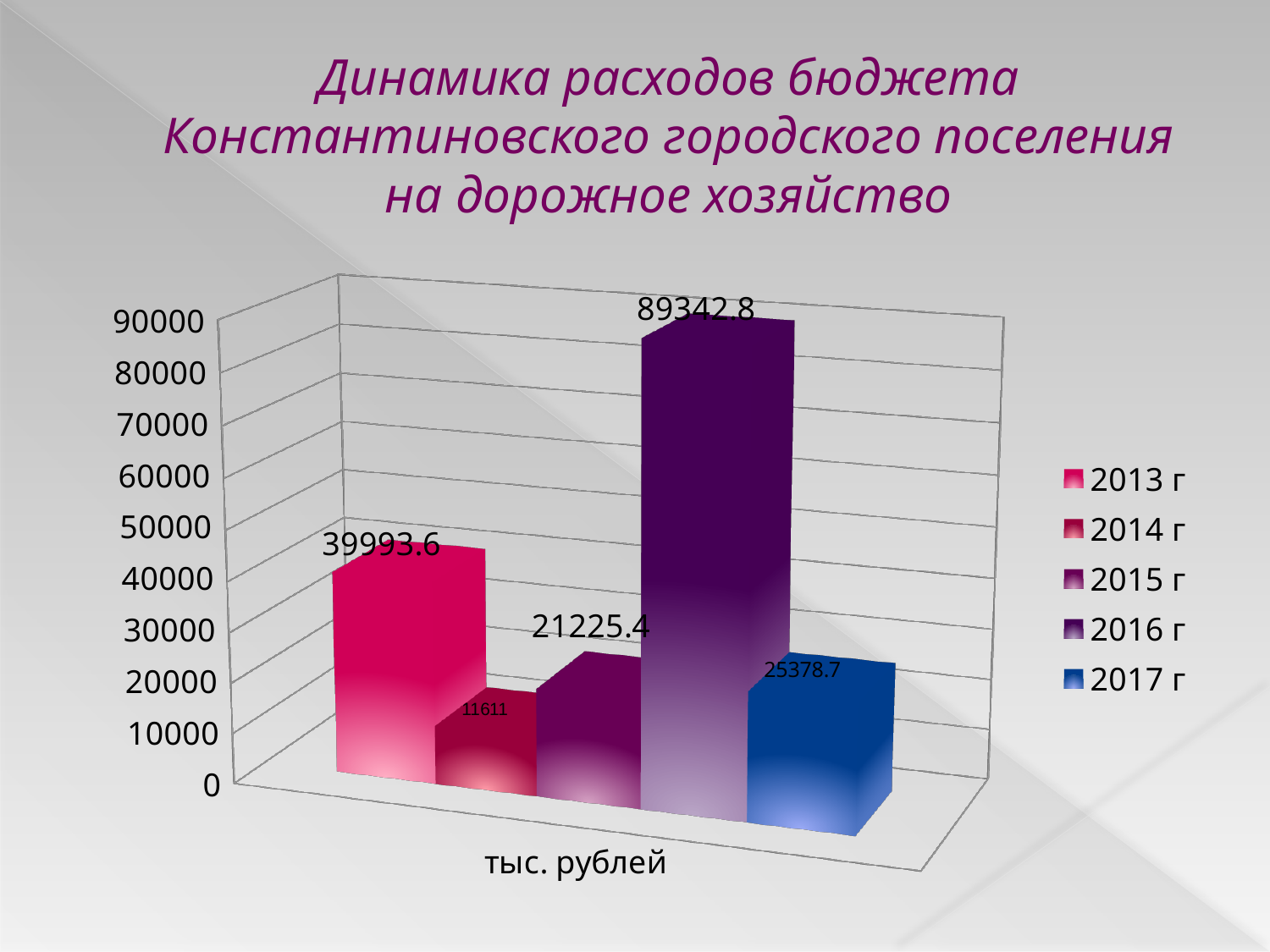
What kind of chart is shown on the slide? bar chart What is the value for 2013 г? 39993.6 Which is larger, the value for 2015 г or the value for 2017 г? 2017 г What is the value for 2014 г? 11611 Which year has the highest value? 2016 г What is the difference between the values for 2016 г and 2013 г? 49349.2 What is the value for 2016 г? 89342.8 Which year has the lowest value? 2014 г Is the value for 2013 г greater or less than 30000? greater What is the value for 2017 г? 25378.7 How many series does the legend list? 5 What unit label is shown below the chart? тыс. рублей